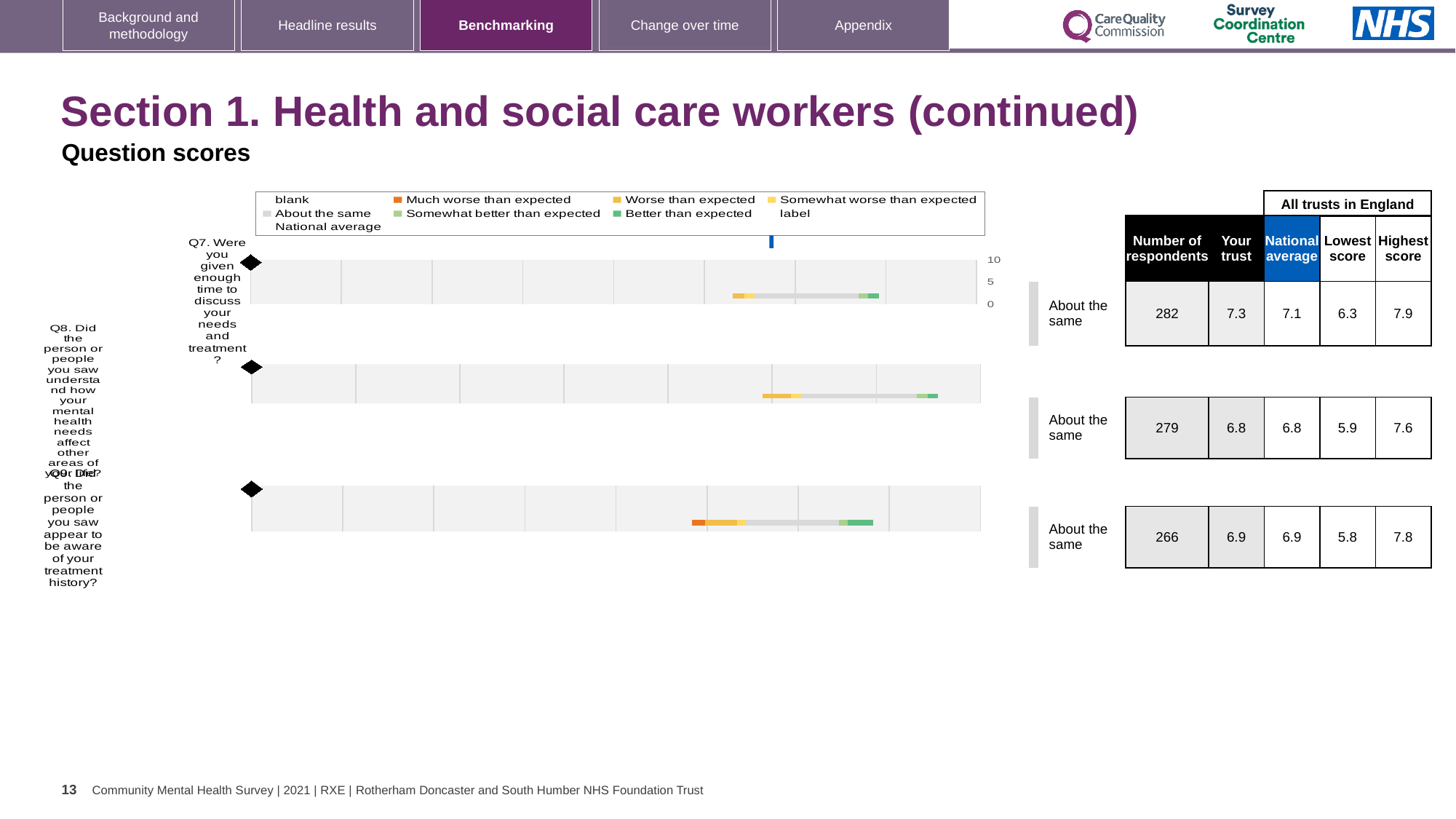
How many questions (Q7, Q8, Q9) are plotted on the slide? 3 For Q7 (Were you given enough time to discuss your needs and treatment?), what is the number of respondents? 282 What is the national average score for Q8 (Did the person or people you saw understand how your mental health needs affect other areas of your life?)? 6.8 Which has the higher 'Highest score' across all trusts in England: Q7 or Q9? Q7 What is the 'Your trust' score for Q7? 7.3 What is the lowest score across all trusts in England for Q9 (Did the person or people you saw appear to be aware of your treatment history?)? 5.8 What benchmark category is shown for Q8? About the same What is the difference between the 'Your trust' score and the national average for Q7? 0.2 Which question has the lowest number of respondents? Q9 What colour does the legend use for 'Much worse than expected'? orange Which question has the highest 'Your trust' score? Q7 What kind of chart is used to show the question scores on this slide? bar chart